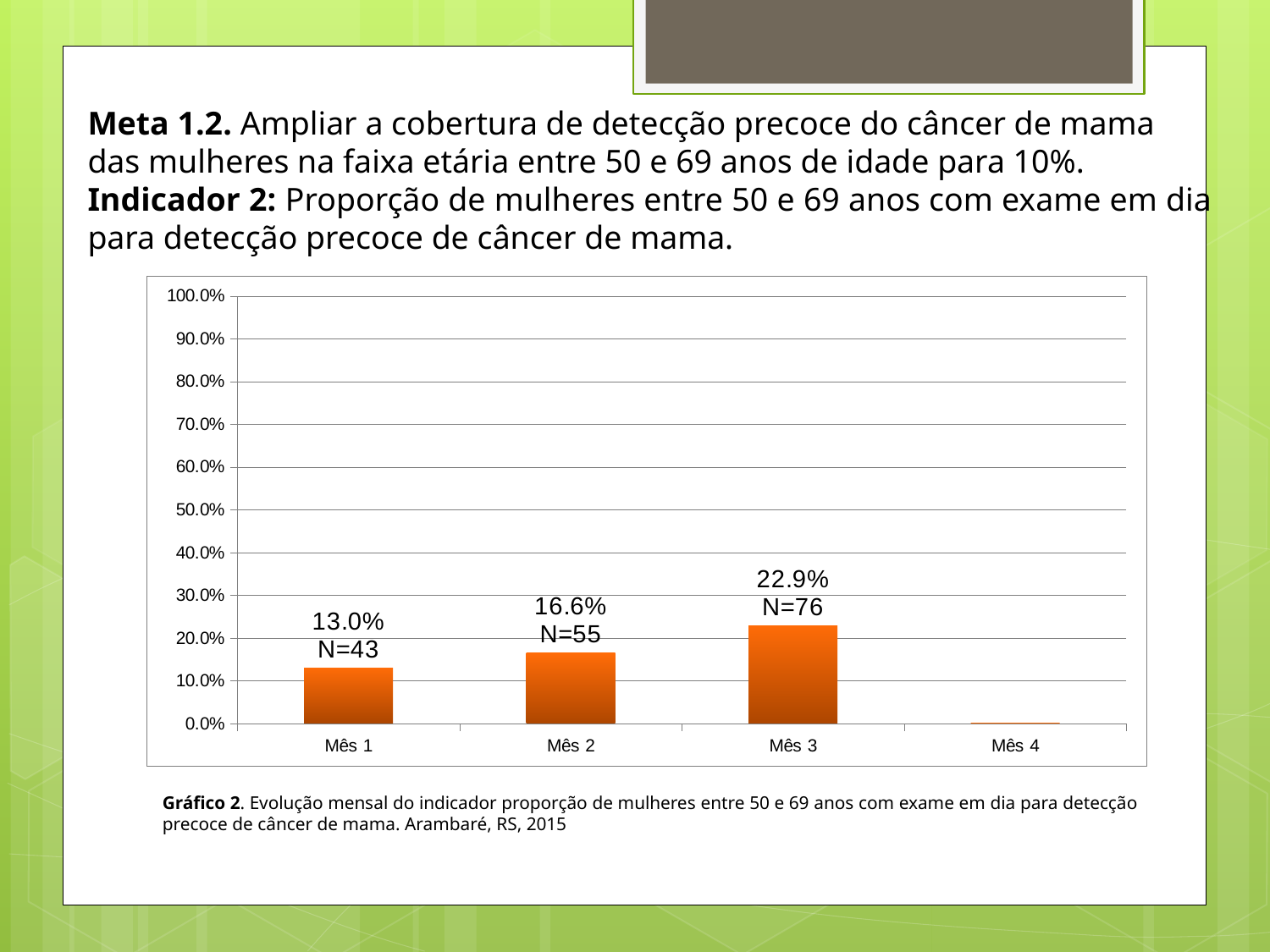
What is the N shown for Mês 2? N=55 Do the values rise or fall from Mês 1 to Mês 3? rise Which month has the lowest value? Mês 4 What is the value for Mês 3? 22.9% Which month has the highest value? Mês 3 Is the value for Mês 4 greater or less than 10.0%? less What is the value for Mês 1? 13.0% How many months are shown on the x axis? 4 What is the difference between the values for Mês 3 and Mês 1? 9.9% What kind of chart is shown on the slide? bar chart Which is larger, the value for Mês 2 or the value for Mês 3? Mês 3 What is the highest value shown on the y axis? 100.0%